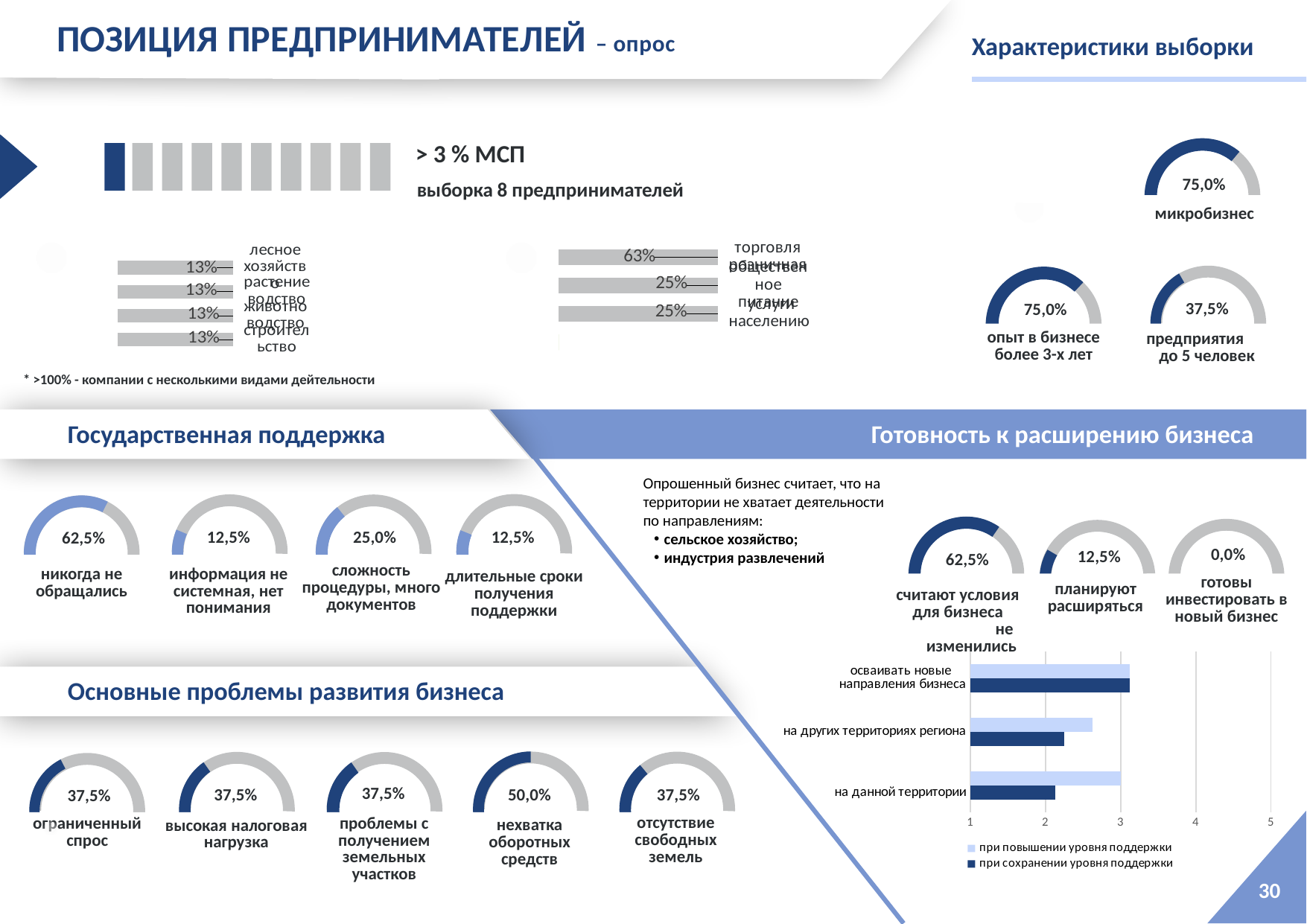
In the horizontal bar chart at the bottom right, for 'на данной территории', which series has the larger value: 'при повышении уровня поддержки' or 'при сохранении уровня поддержки'? при повышении уровня поддержки In the horizontal bar chart at the bottom right, how many categories are shown on the vertical axis? 3 In the horizontal bar chart at the bottom right, is the value for 'на данной территории' in the series 'при сохранении уровня поддержки' greater or less than 3? less In the bar chart in the top middle of the slide, what is the value shown for 'торговля розничная'? 63% In the 'Готовность к расширению бизнеса' section, what is the value shown for 'готовы инвестировать в новый бизнес'? 0,0% In the 'Государственная поддержка' section, what is the value shown for 'никогда не обращались'? 62,5% In the horizontal bar chart at the bottom right, is the value for 'на других территориях региона' in the series 'при сохранении уровня поддержки' greater or less than 3? less In the 'Основные проблемы развития бизнеса' section, what is the value shown for 'нехватка оборотных средств'? 50,0% In the 'Основные проблемы развития бизнеса' section, which problem has the highest gauge value? нехватка оборотных средств In the horizontal bar chart at the bottom right (under 'Готовность к расширению бизнеса'), how many series does the legend list? 2 In the 'Характеристики выборки' section, what is the difference between the gauge values for 'микробизнес' and 'предприятия до 5 человек'? 37,5% What kind of chart is the one at the bottom right with the legend 'при повышении уровня поддержки' and 'при сохранении уровня поддержки'? bar chart